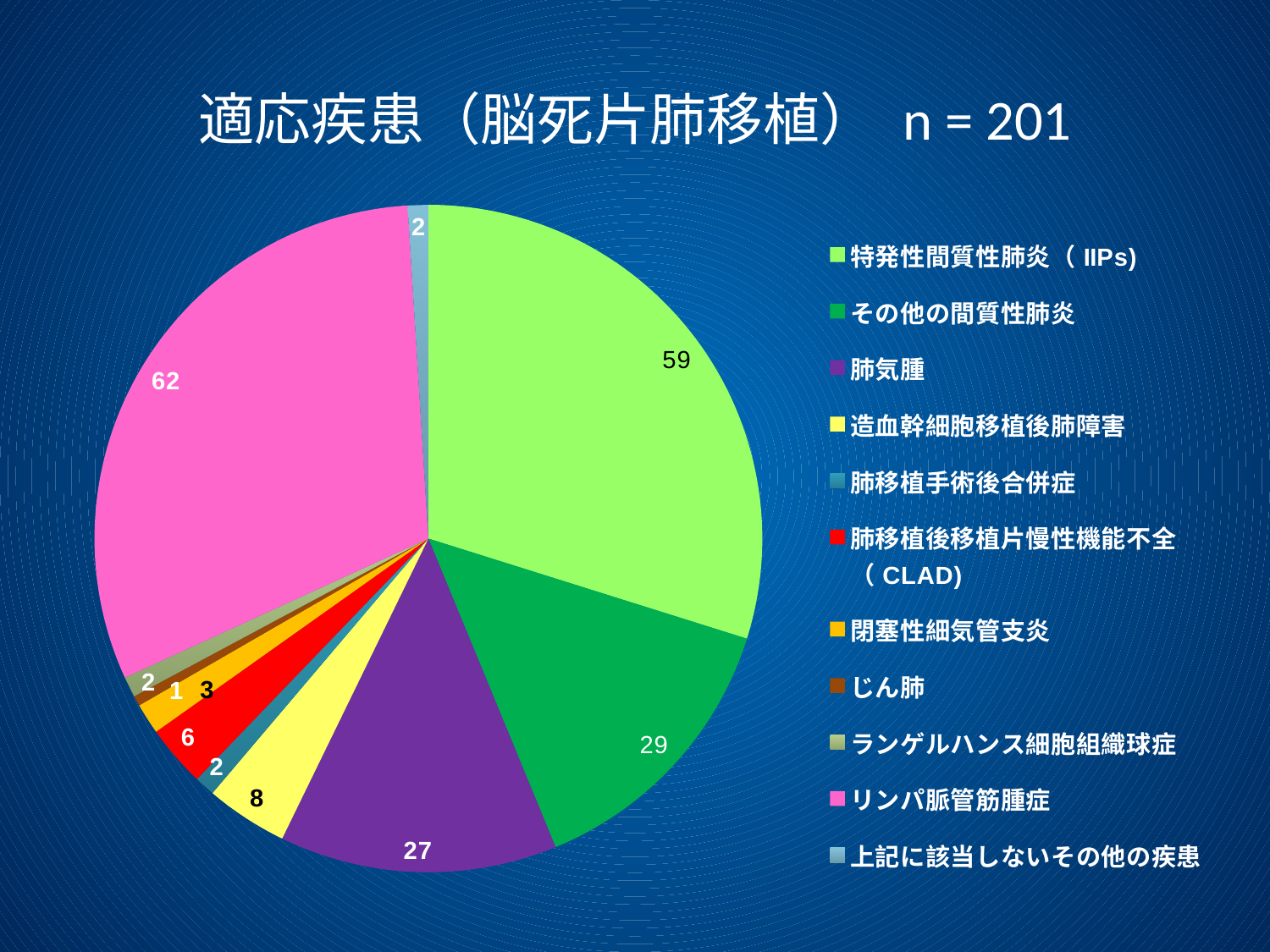
What is the value for 特発性間質性肺炎（IIPs)? 59 What is the total n stated in the chart title? 201 What is the value for 肺気腫? 27 What is the value for リンパ脈管筋腫症? 62 What is the value for 肺移植後移植片慢性機能不全（CLAD)? 6 What kind of chart is shown on the slide? pie chart What is the difference between the values for リンパ脈管筋腫症 and 特発性間質性肺炎（IIPs)? 3 What is the value for 造血幹細胞移植後肺障害? 8 How many categories does the legend list? 11 Which category has the largest slice of the pie? リンパ脈管筋腫症 Which category has the smallest slice of the pie? じん肺 Which is larger, the value for その他の間質性肺炎 or the value for 肺気腫? その他の間質性肺炎